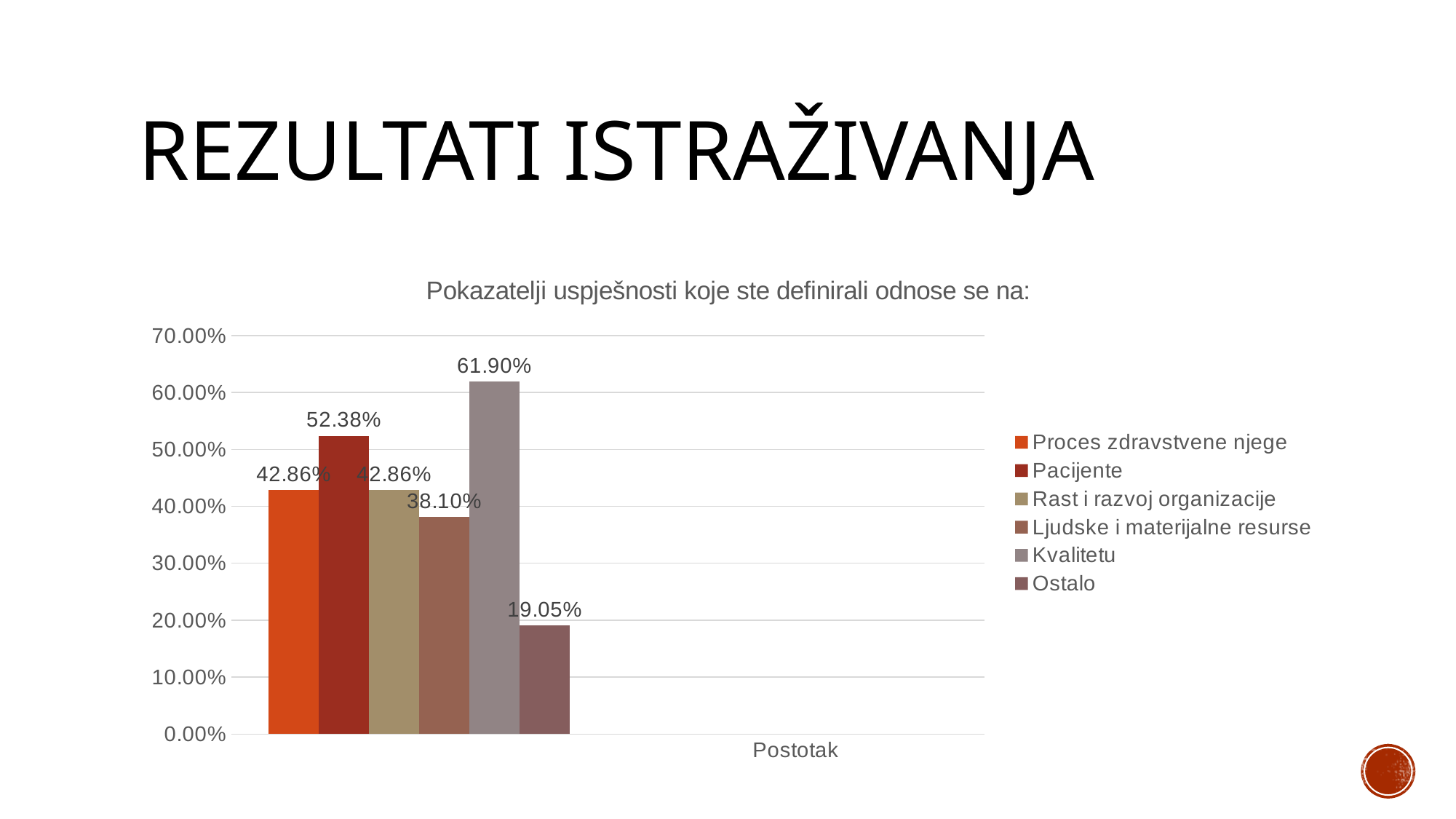
Which series has the highest value? Kvalitetu Which is larger, the value for Pacijente or the value for Ljudske i materijalne resurse? Pacijente What is the value for Pacijente? 52.38% What is the value for Kvalitetu? 61.90% What is the value for Ljudske i materijalne resurse? 38.10% What kind of chart is shown on the slide? Bar chart What is the difference between the values for Proces zdravstvene njege and Ostalo? 23.81% What is the title of the chart? Pokazatelji uspješnosti koje ste definirali odnose se na: What is the value for Ostalo? 19.05% How many series does the legend list? 6 What is the difference between the values for Kvalitetu and Pacijente? 9.52% Which series has the lowest value? Ostalo